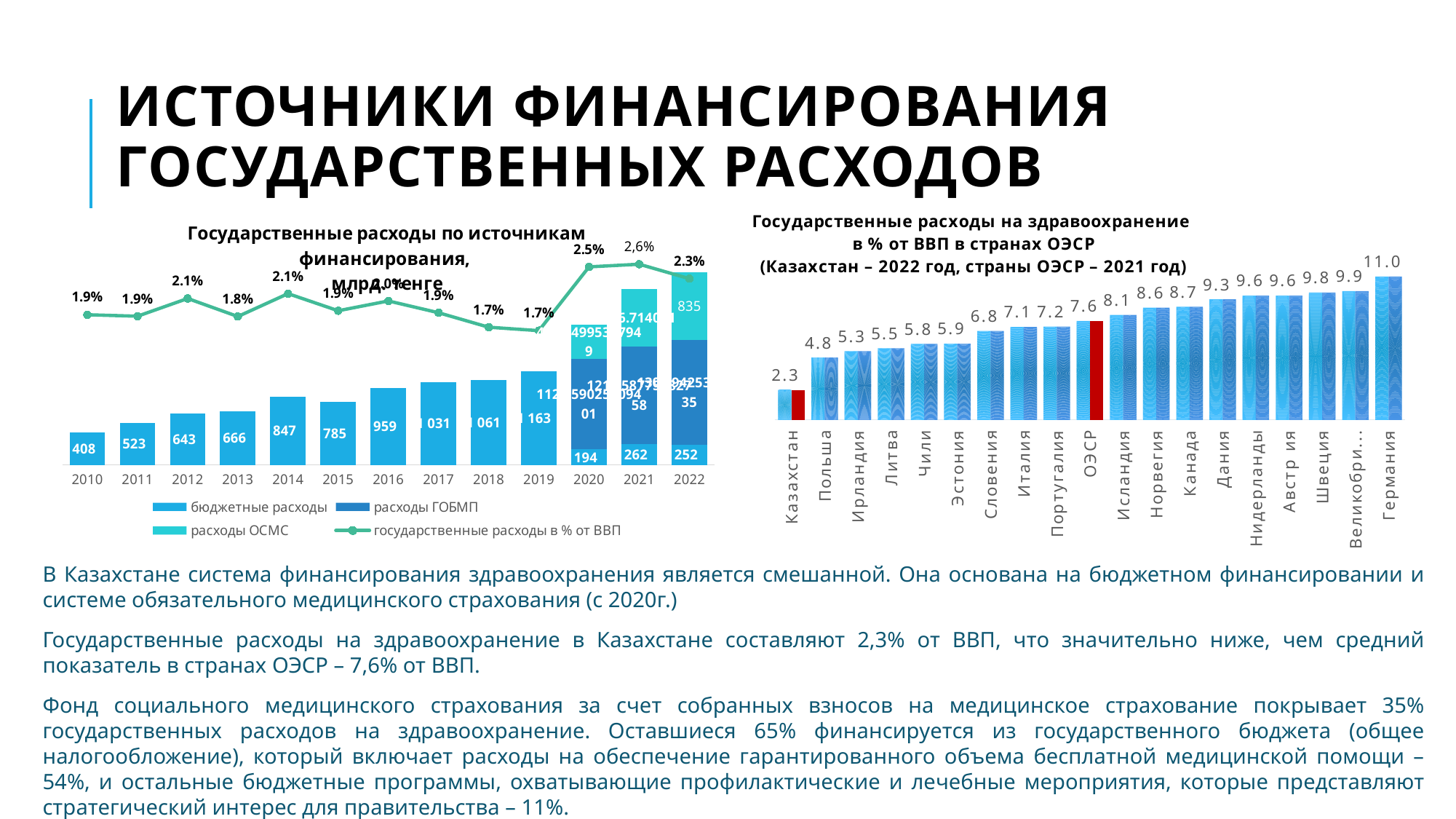
In the left chart (Государственные расходы по источникам финансирования), what is the value of бюджетные расходы for 2010? 408 In the right chart (Государственные расходы на здравоохранение в % от ВВП в странах ОЭСР), which country has the highest value? Германия In the right chart (Государственные расходы на здравоохранение в % от ВВП в странах ОЭСР), what is the value for Германия? 11.0 In the left chart (Государственные расходы по источникам финансирования), what is the value of государственные расходы в % от ВВП for 2020? 2.5% In the left chart (Государственные расходы по источникам финансирования), do бюджетные расходы rise or fall from 2010 to 2014? rise In the right chart (Государственные расходы на здравоохранение в % от ВВП в странах ОЭСР), which category has the lowest value? Казахстан In the left chart (Государственные расходы по источникам финансирования), how many series does the legend list? 4 In the right chart (Государственные расходы на здравоохранение в % от ВВП в странах ОЭСР), what is the value for Казахстан? 2.3 In the left chart (Государственные расходы по источникам финансирования), what is the difference between бюджетные расходы in 2019 and in 2010? 755 In the right chart (Государственные расходы на здравоохранение в % от ВВП в странах ОЭСР), which is larger, the value for Канада or for Норвегия? Канада In the right chart (Государственные расходы на здравоохранение в % от ВВП в странах ОЭСР), what is the difference between the ОЭСР value and the Казахстан value? 5.3